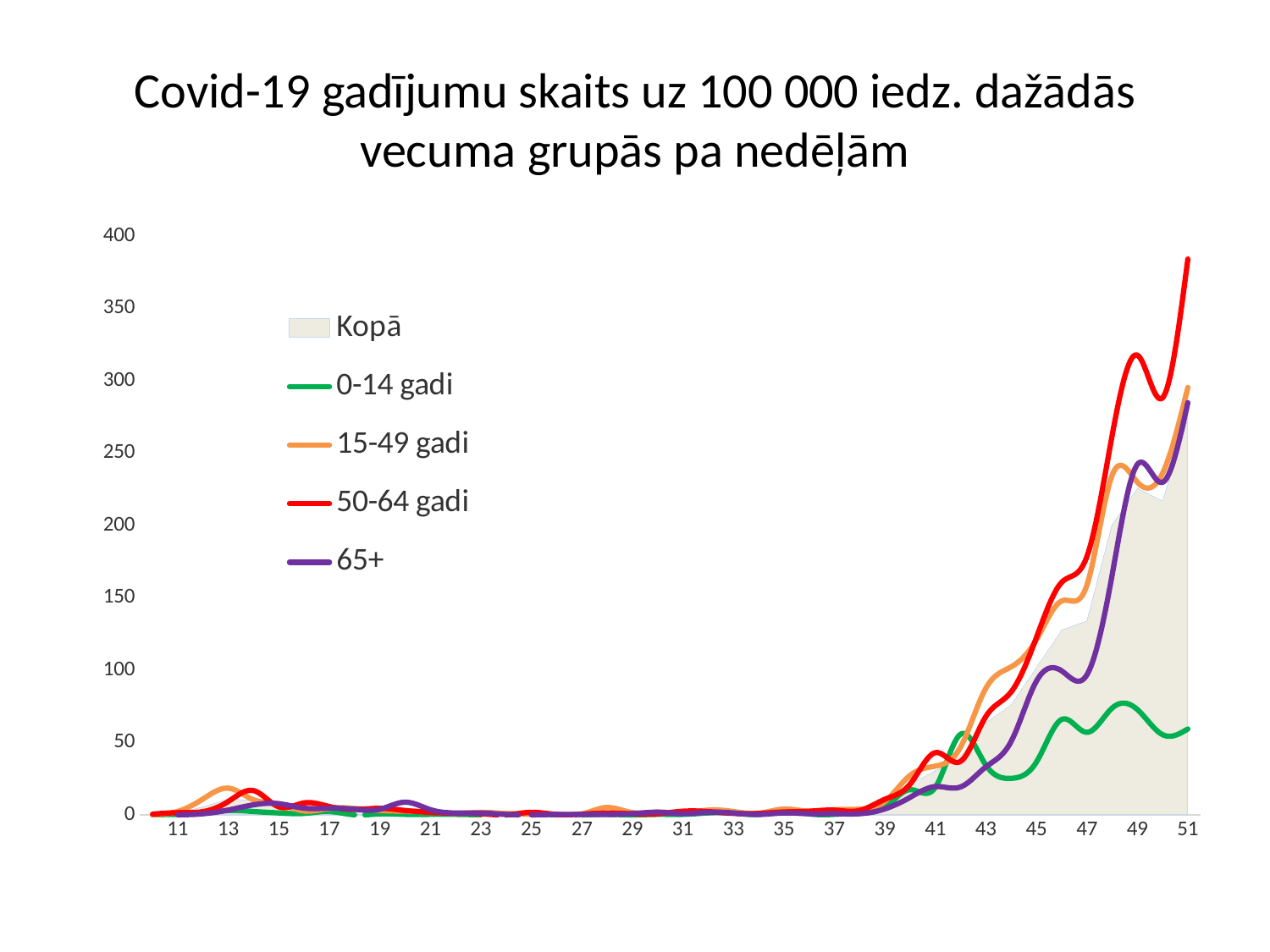
What kind of chart is shown on the slide? combination area and line chart At week 51, which is larger: the value for 50-64 gadi or the value for 15-49 gadi? 50-64 gadi Which age group has the lowest value at week 51? 0-14 gadi How many series does the legend list? 5 Which age group has the highest value at week 51? 50-64 gadi Is the value for 50-64 gadi at week 49 greater or less than 300? greater Is the value for 65+ at week 51 greater or less than 250? greater Do the values for 50-64 gadi rise or fall from week 39 to week 51? rise Is the value for 50-64 gadi at week 51 greater or less than 350? greater What colour is the line for 65+ in the legend? purple